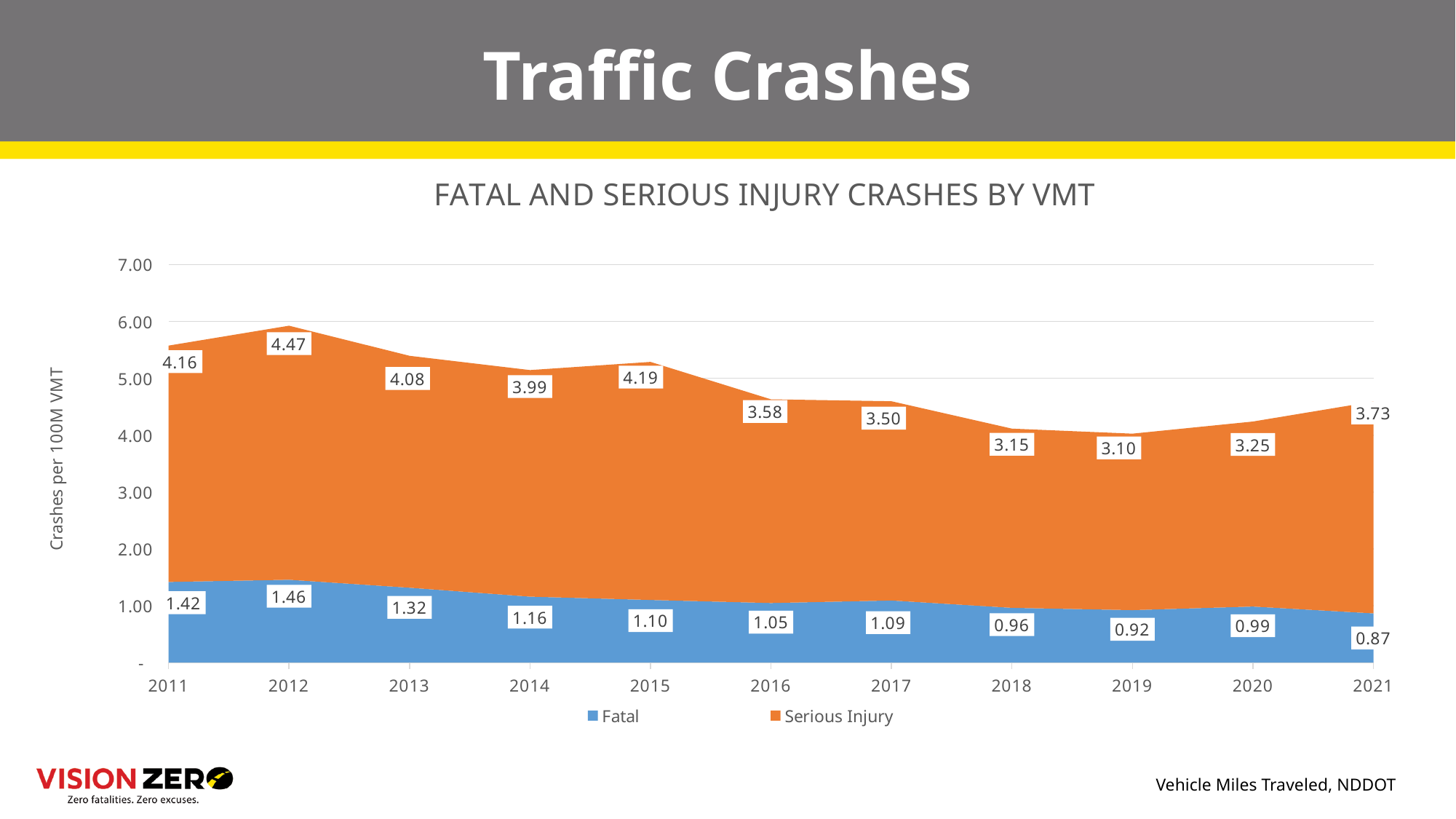
Which is larger, the Fatal value for 2014 or the Fatal value for 2017? 2014 Which year has the highest Serious Injury value? 2012 How many series does the legend list? 2 What is the difference between the Serious Injury values for 2012 and 2021? 0.74 What is the Serious Injury value for 2012? 4.47 What is the Fatal value for 2019? 0.92 What is the combined Fatal and Serious Injury value for 2012? 5.93 Which year has the lowest Fatal value? 2021 How many years are shown on the x axis? 11 What is the Serious Injury value for 2021? 3.73 What kind of chart is shown on the slide? Area chart Which year has the lowest Serious Injury value? 2019